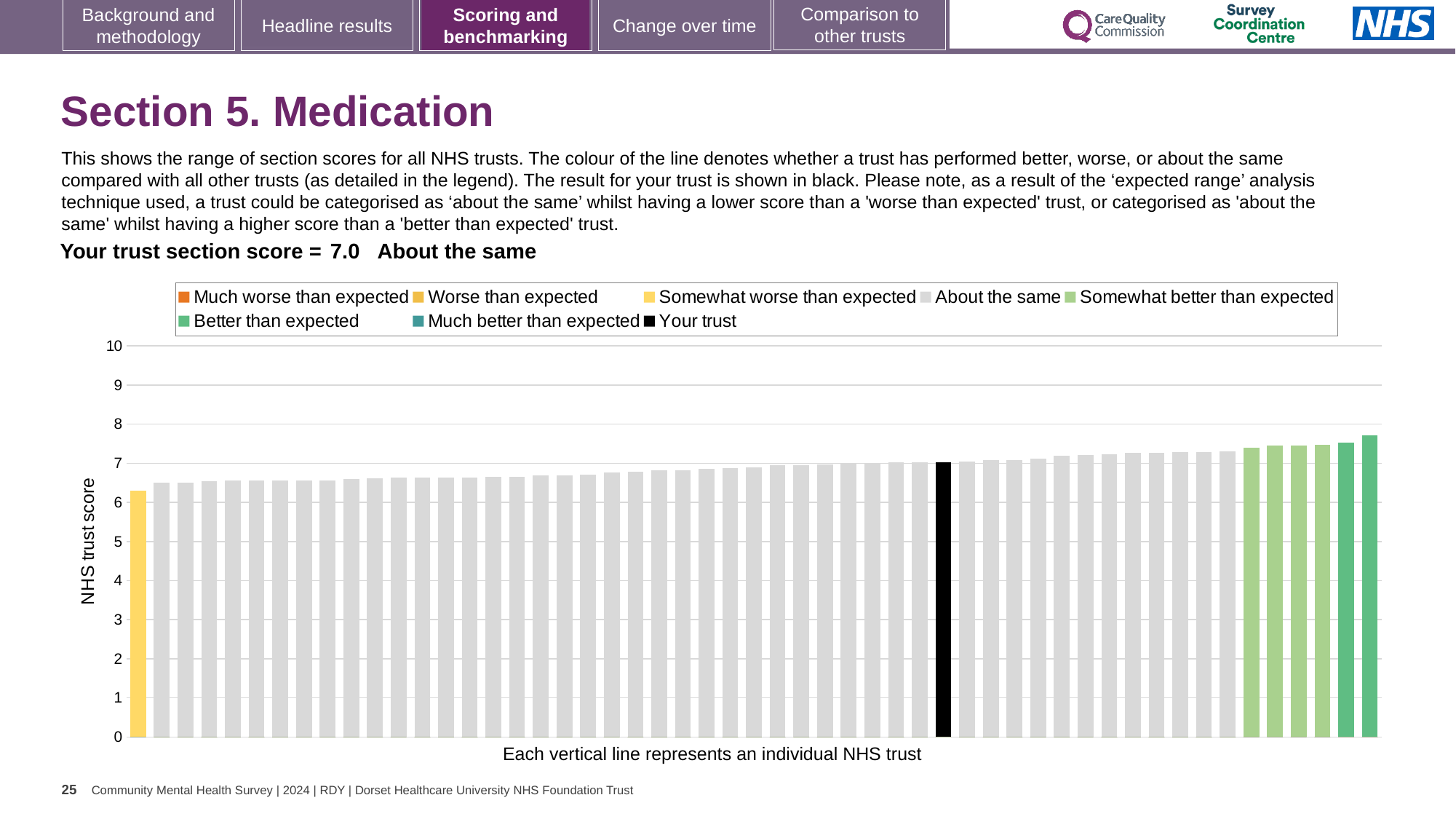
Is the value of the leftmost (yellow) bar greater or less than 6? greater What kind of chart is shown on the slide? bar chart Do the bar values rise or fall from left to right along the x axis? rise Is the value of the leftmost (yellow) bar greater or less than 7? less Which legend category does the lowest bar in the chart belong to? Somewhat worse than expected What is the label on the vertical axis of the chart? NHS trust score Is the value of the tallest bar on the right greater or less than 8? less How many entries does the chart legend list? 8 What colour is the bar representing your trust in the chart? black What is the section score for your trust shown on the slide? 7.0 How is your trust's section score categorised compared with other trusts? About the same